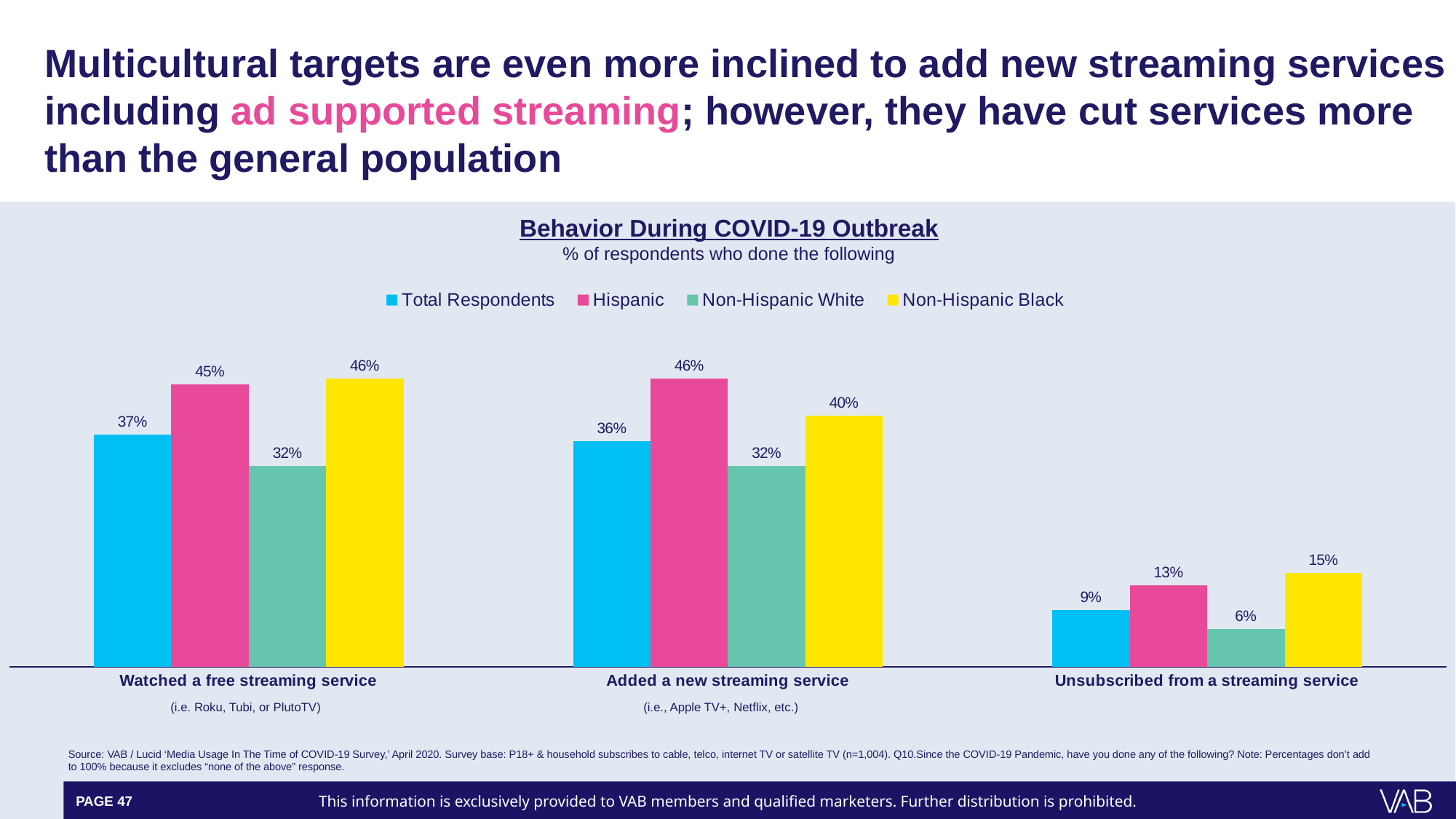
Which colour represents the Hispanic series in the legend? Pink Which group has the highest value for 'Unsubscribed from a streaming service'? Non-Hispanic Black What percentage of Hispanic respondents watched a free streaming service? 45% What is the difference between the Hispanic and Non-Hispanic White values for 'Added a new streaming service'? 14 percentage points What percentage of Non-Hispanic Black respondents added a new streaming service? 40% What is the title of the chart? Behavior During COVID-19 Outbreak Which is larger for 'Watched a free streaming service': the Total Respondents value or the Non-Hispanic White value? Total Respondents How many behavior categories are shown on the x axis? 3 What kind of chart is shown on the slide? Bar chart Which group has the lowest value for 'Added a new streaming service'? Non-Hispanic White How many series does the legend list? 4 What percentage of Total Respondents unsubscribed from a streaming service? 9%